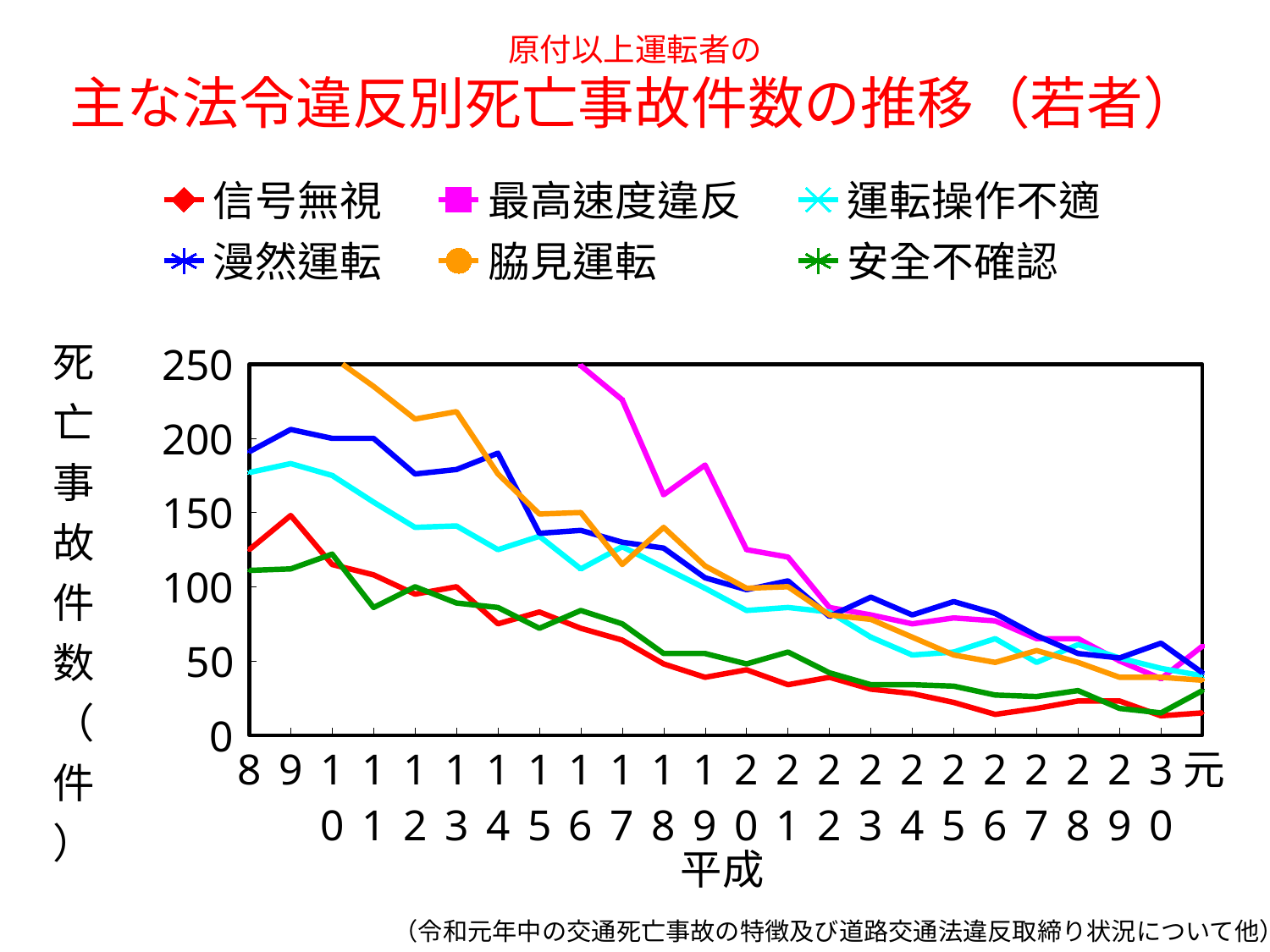
Is the value for 信号無視 in 平成9 greater or less than 100? greater Does the 信号無視 line generally rise or fall from 平成8 to 令和元? fall Is the value for 最高速度違反 in 平成17 greater or less than 200? greater Is the value for 安全不確認 in 令和元 greater or less than 50? less Which series has the lowest value in 平成26? 信号無視 In 平成8, which is larger: 漫然運転 or 信号無視? 漫然運転 What colour is the 脇見運転 line in the legend? orange Which series has the highest value in 平成17? 最高速度違反 What kind of chart is shown on the slide? line chart Does the 最高速度違反 line generally rise or fall across the years shown? fall How many points along the x axis does each line cover (平成8 through 令和元)? 24 How many series does the legend list? 6